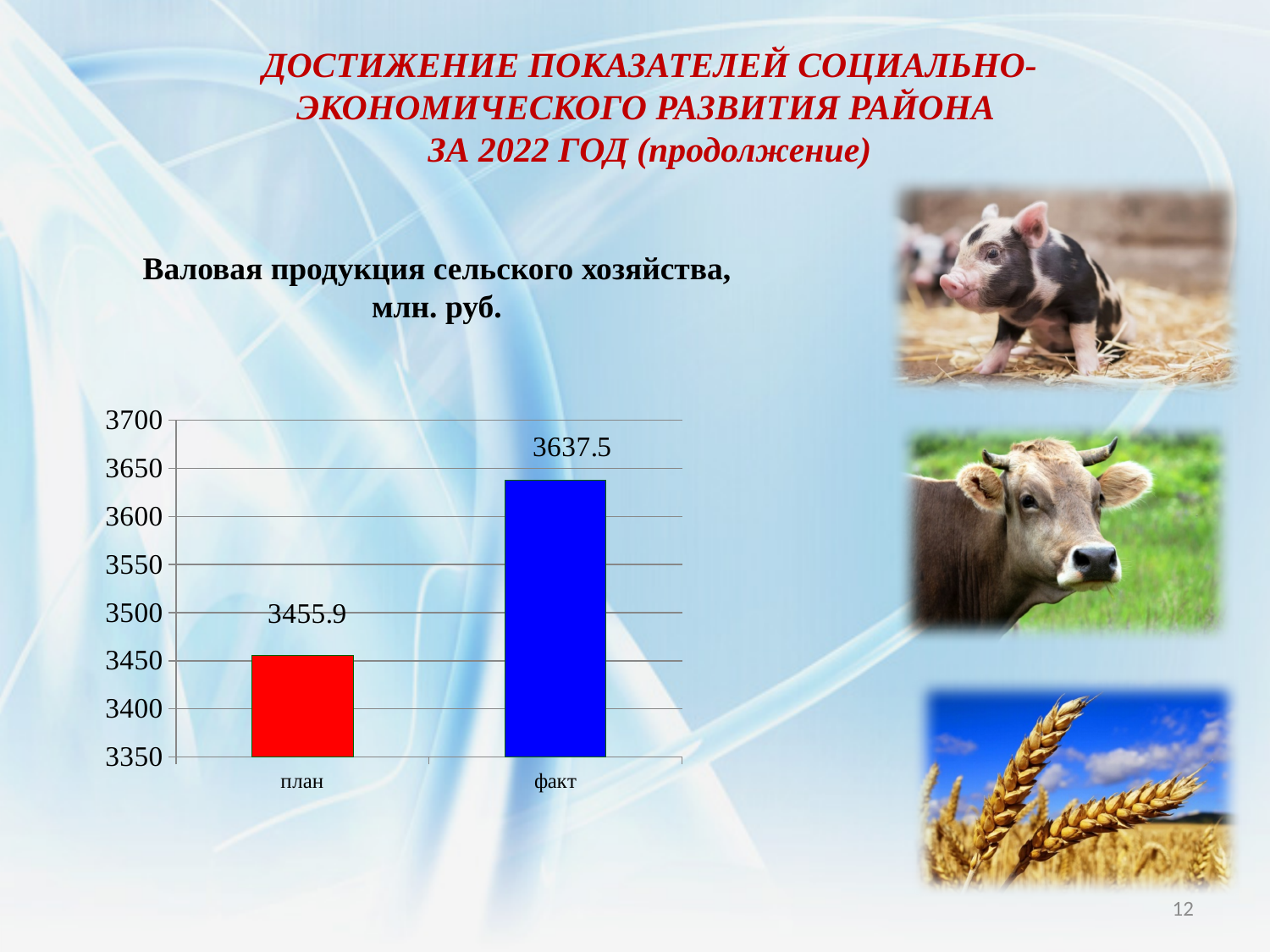
Which category has the lowest value? план What colour is the bar for факт? blue Is the value for факт greater or less than 3600? greater How many categories are shown on the x axis? 2 What is the difference between the values for факт and план? 181.6 What is the value for факт? 3637.5 Which category has the highest value? факт Which is larger, the value for план or the value for факт? факт What is the title of the chart? Валовая продукция сельского хозяйства, млн. руб. What is the value for план? 3455.9 Is the value for план greater or less than 3500? less What kind of chart is shown on the slide? bar chart